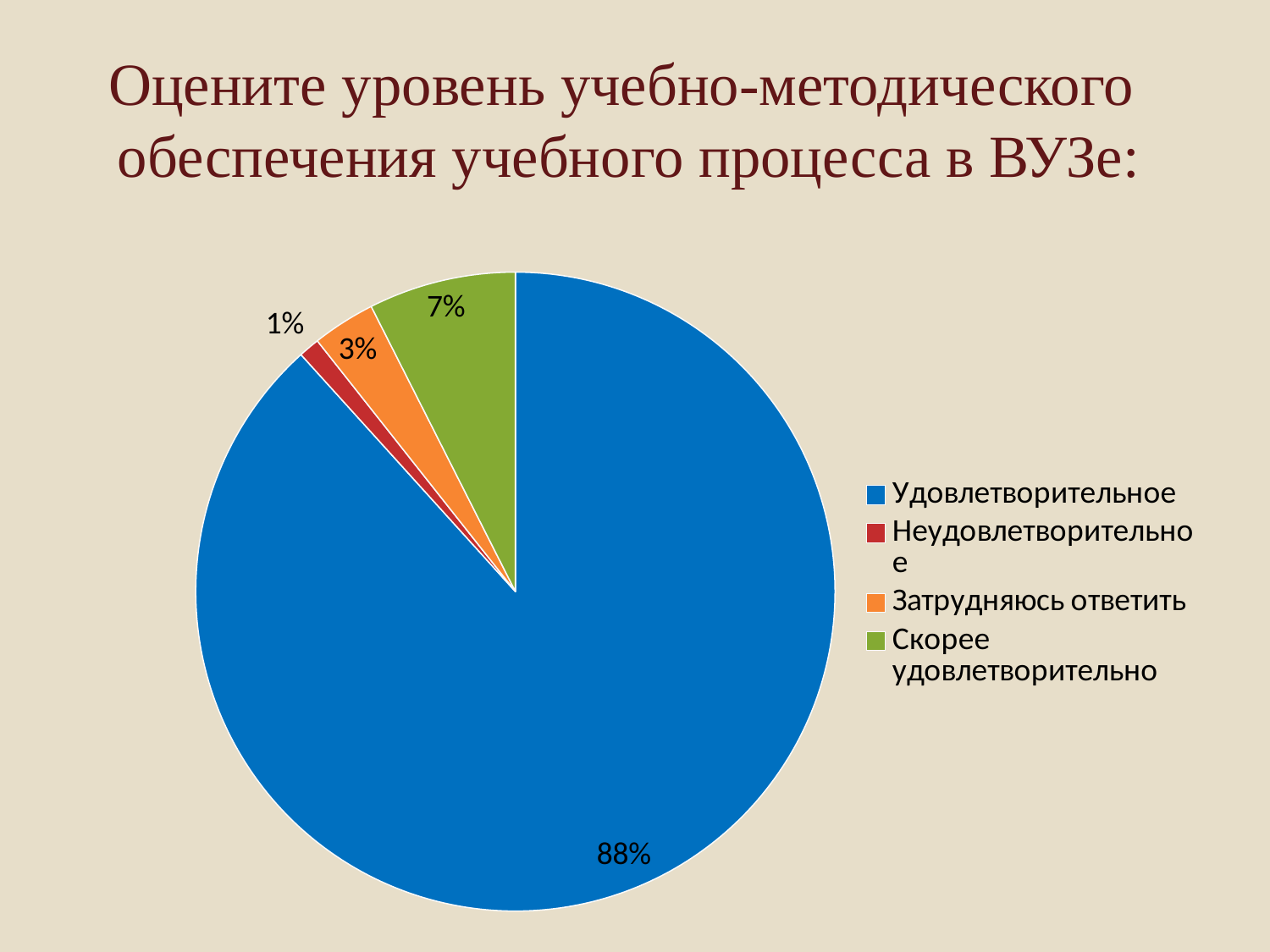
Which is larger: the slice for Затрудняюсь ответить or the slice for Скорее удовлетворительно? Скорее удовлетворительно How many slices does the pie chart have? 4 What colour is the slice for Затрудняюсь ответить? Orange Which category has the largest slice of the pie? Удовлетворительное What share of the pie is labelled Скорее удовлетворительно? 7% Which category has the smallest slice of the pie? Неудовлетворительное What share of the pie is labelled Затрудняюсь ответить? 3% What is the combined share of Неудовлетворительное and Затрудняюсь ответить? 4% What kind of chart is shown on the slide? Pie chart What share of the pie is labelled Удовлетворительное? 88% What is the difference in percentage points between Удовлетворительное and Скорее удовлетворительно? 81 What share of the pie is labelled Неудовлетворительное? 1%